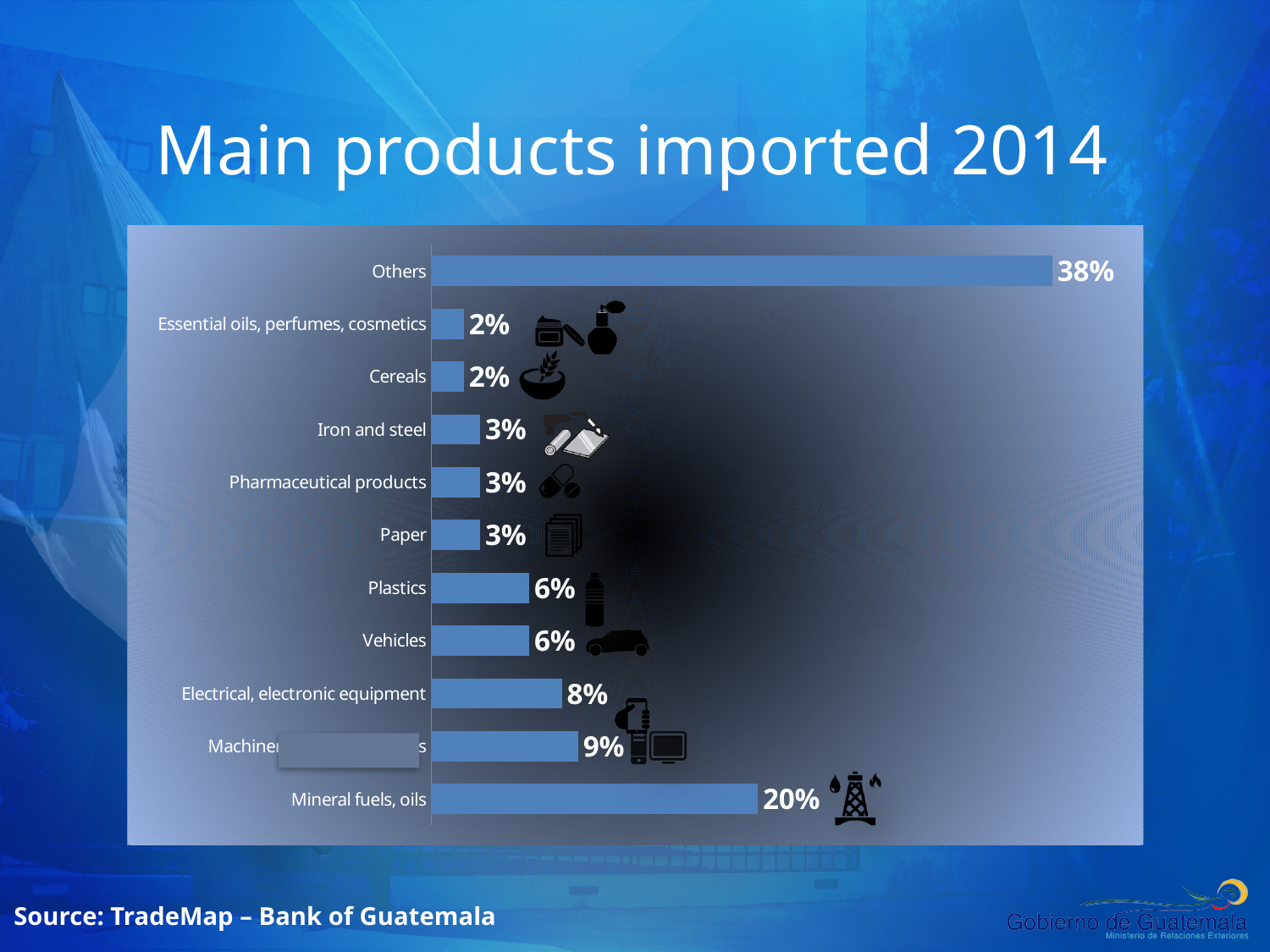
Which is larger, the value for Electrical, electronic equipment or the value for Plastics? Electrical, electronic equipment What is the difference between the values for Others and Mineral fuels, oils? 18% Which category has the highest value? Others What is the difference between the values for Plastics and Paper? 3% What is the value for Pharmaceutical products? 3% Which is larger, the value for Vehicles or the value for Iron and steel? Vehicles What is the value for Electrical, electronic equipment? 8% What is the value for Mineral fuels, oils? 20% What is the value for Cereals? 2% How many categories are shown in the chart? 11 What kind of chart is shown on the slide? Bar chart What is the title of the slide? Main products imported 2014